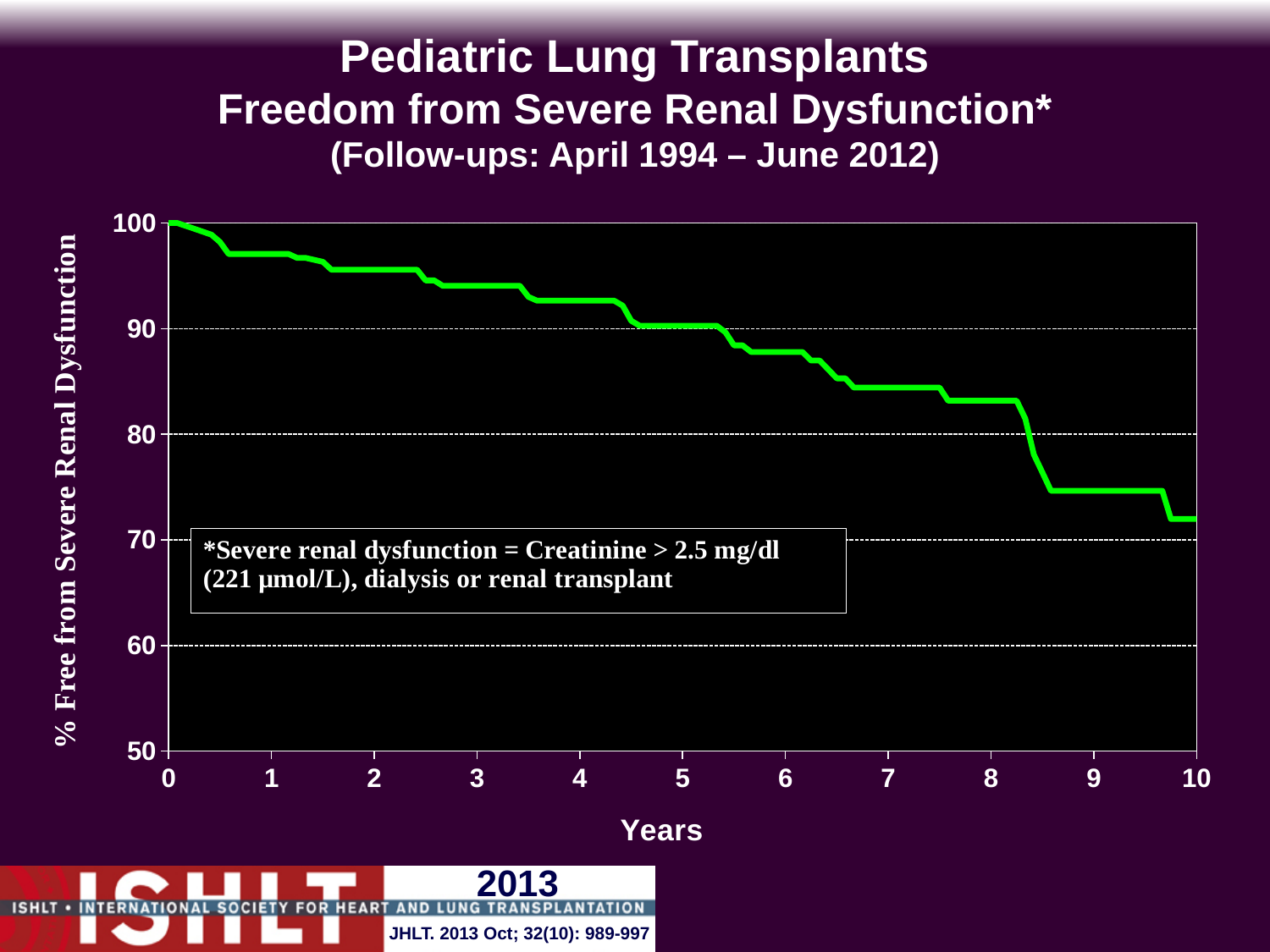
Is the value at year 6 greater or less than 90? less Is the value at year 8 greater or less than 80? greater Which is larger, the value at year 3 or the value at year 9? year 3 What colour is the plotted line? green Is the value at year 7 greater or less than 90? less What kind of chart is shown on the slide? line chart What is the label of the x axis? Years Does the plotted line rise or fall as the years increase? fall What is the value of the curve at year 0? 100